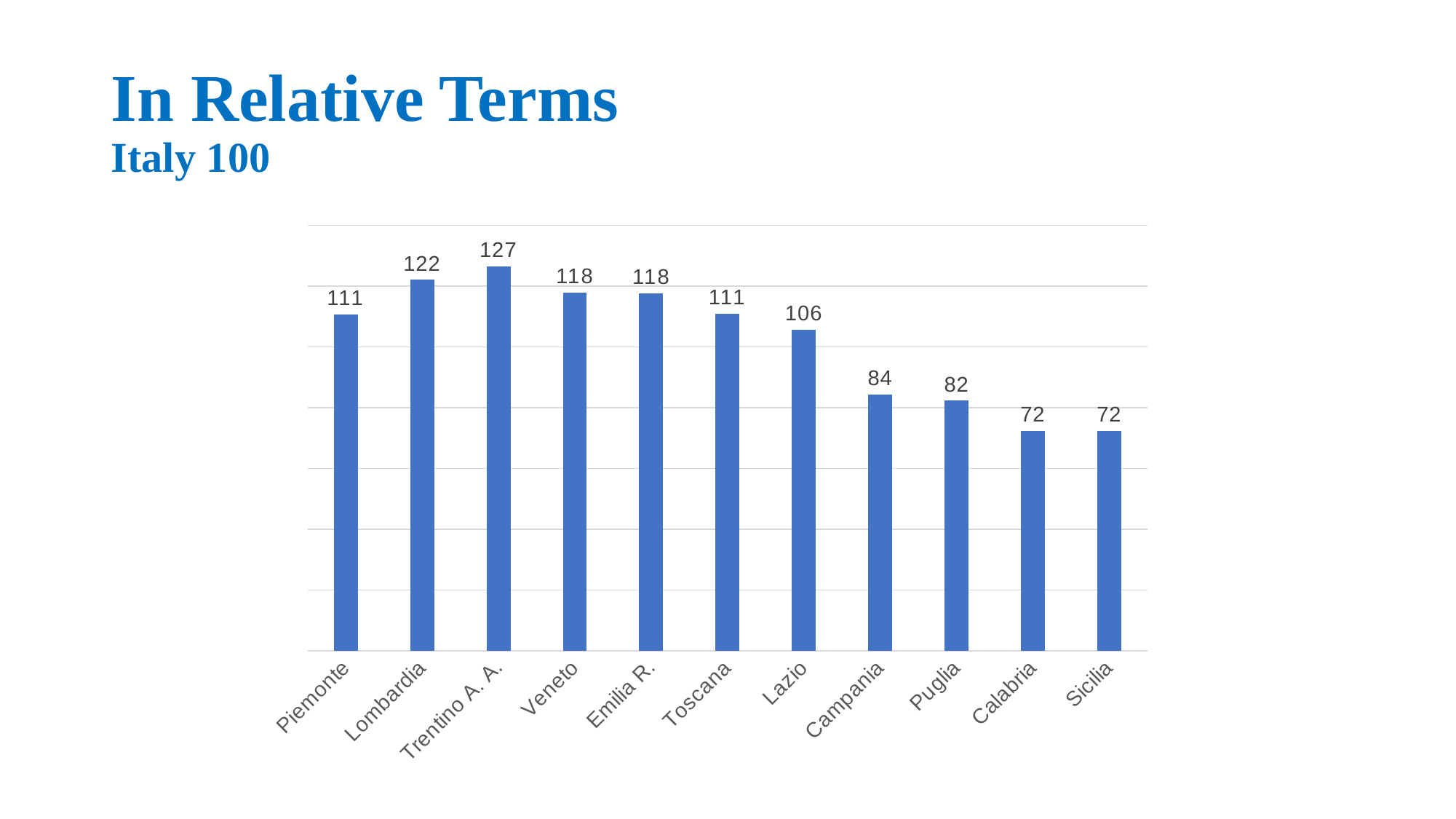
What is the difference between the values for Trentino A. A. and Puglia? 45 Which is larger, the value for Campania or the value for Calabria? Campania What is the difference between the values for Veneto and Lazio? 12 Which region has the highest value? Trentino A. A. How many regions are shown in the chart? 11 What is the value for Campania? 84 What is the value for Lazio? 106 Which is larger, the value for Lombardia or the value for Toscana? Lombardia What kind of chart is shown on the slide? Bar chart What is the value for Sicilia? 72 What is the title of the slide? In Relative Terms What is the value for Lombardia? 122